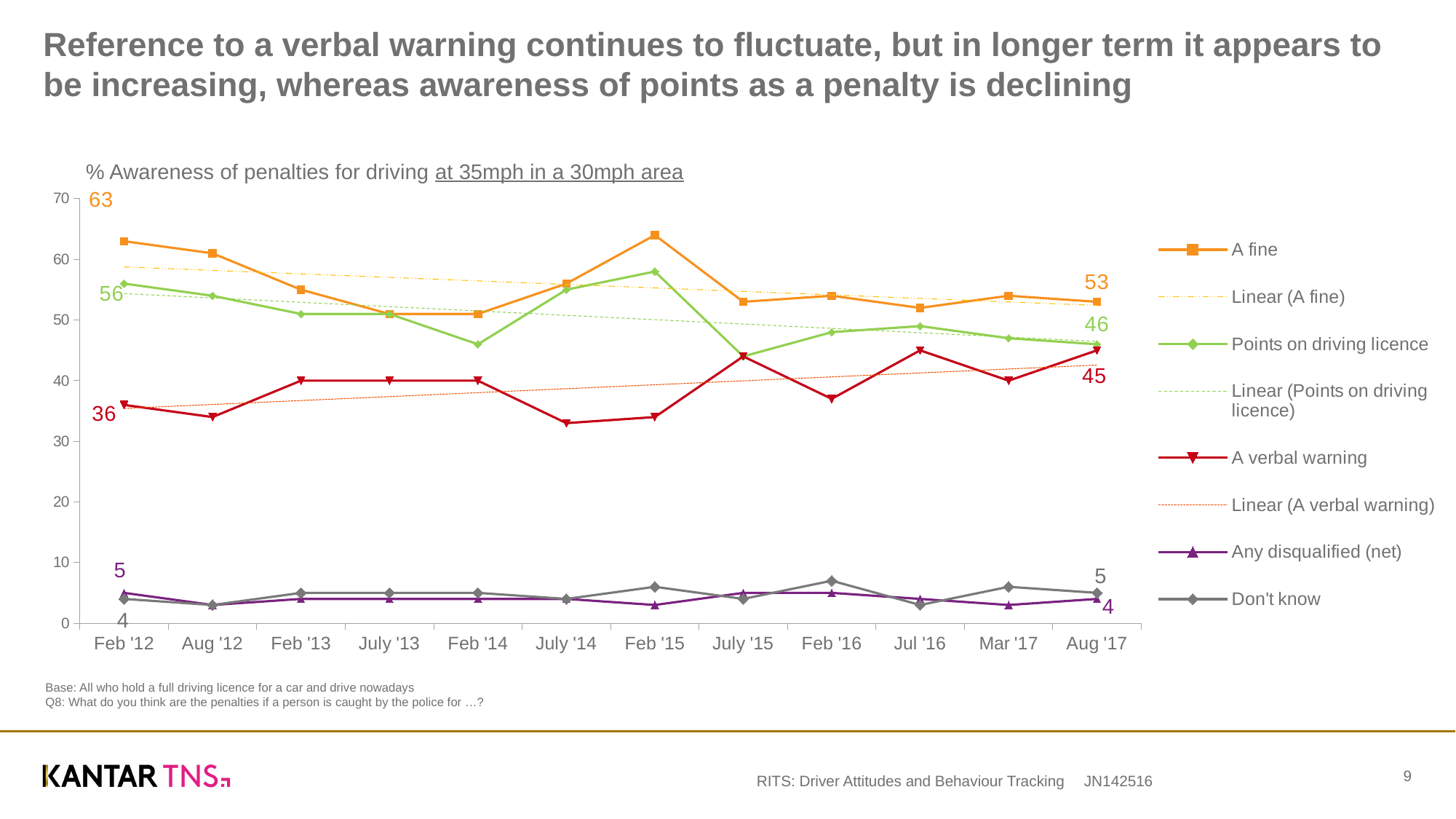
In Feb '12, which is larger: 'A fine' or 'Points on driving licence'? A fine What is the value for 'A fine' in Aug '17? 53 What is the value for 'A fine' in Feb '12? 63 How many entries does the legend list? 8 How many time points are shown on the x axis? 12 What is the value for 'A verbal warning' in Aug '17? 45 What is the value for 'Points on driving licence' in Feb '12? 56 What kind of chart is shown on the slide? line chart By how much did the value for 'A verbal warning' rise between Feb '12 and Aug '17? 9 Is the value for 'A verbal warning' in July '14 greater or less than 40? less Is the value for 'A fine' in Feb '15 greater or less than 60? greater By how much did the value for 'A fine' fall between Feb '12 and Aug '17? 10